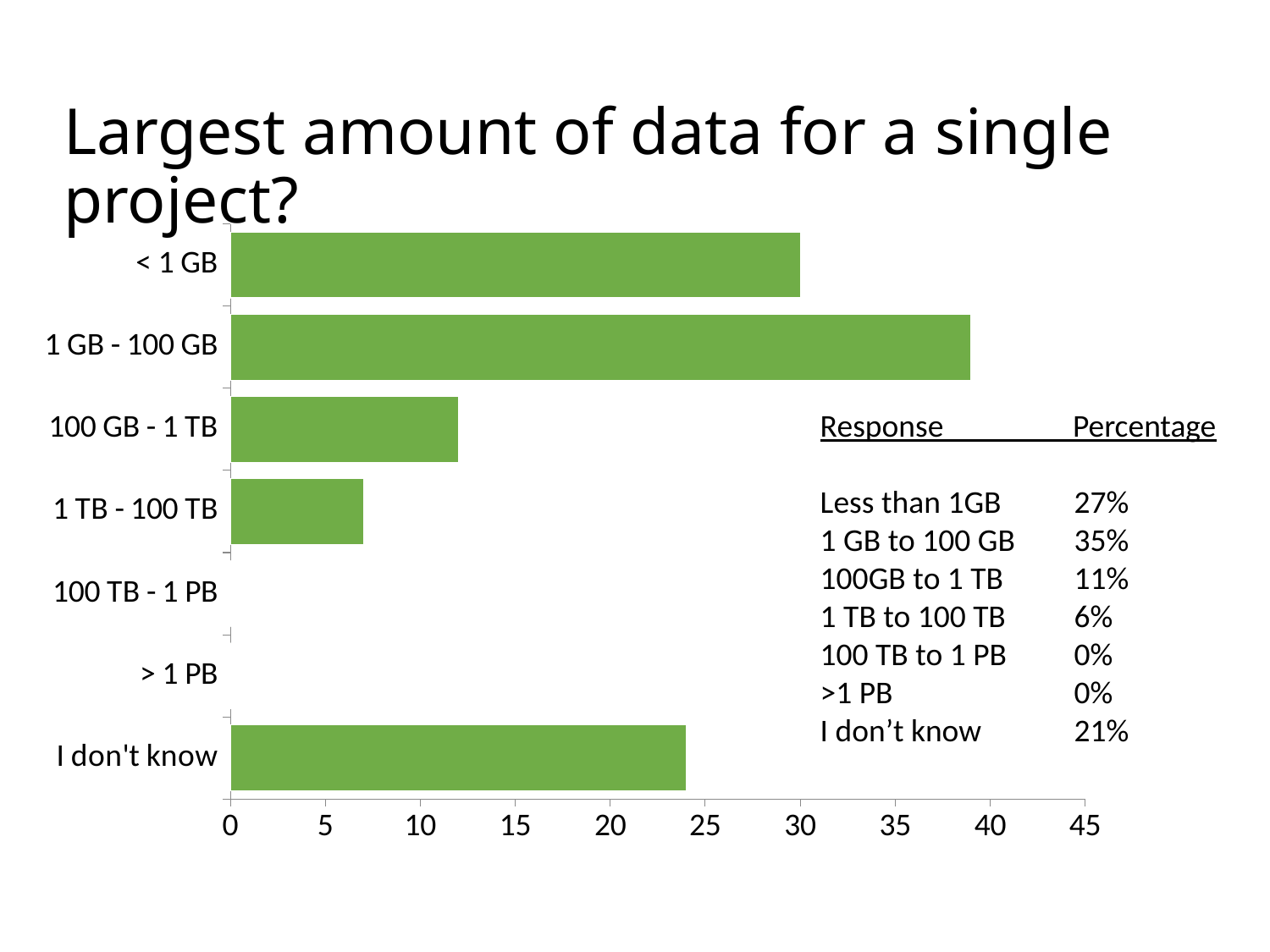
Is the value for 100 GB - 1 TB greater or less than 10? greater What kind of chart is shown on the slide? bar chart Is the value for 1 GB - 100 GB greater or less than 35? greater Is the value for < 1 GB greater or less than 25? greater What is the title of the slide's chart? Largest amount of data for a single project? How many categories are shown on the chart's vertical axis? 7 Which is larger, the value for 100 GB - 1 TB or the value for 1 TB - 100 TB? 100 GB - 1 TB Which is larger, the value for < 1 GB or the value for I don't know? < 1 GB Which category has the longest bar? 1 GB - 100 GB What colour are the bars in the chart? green